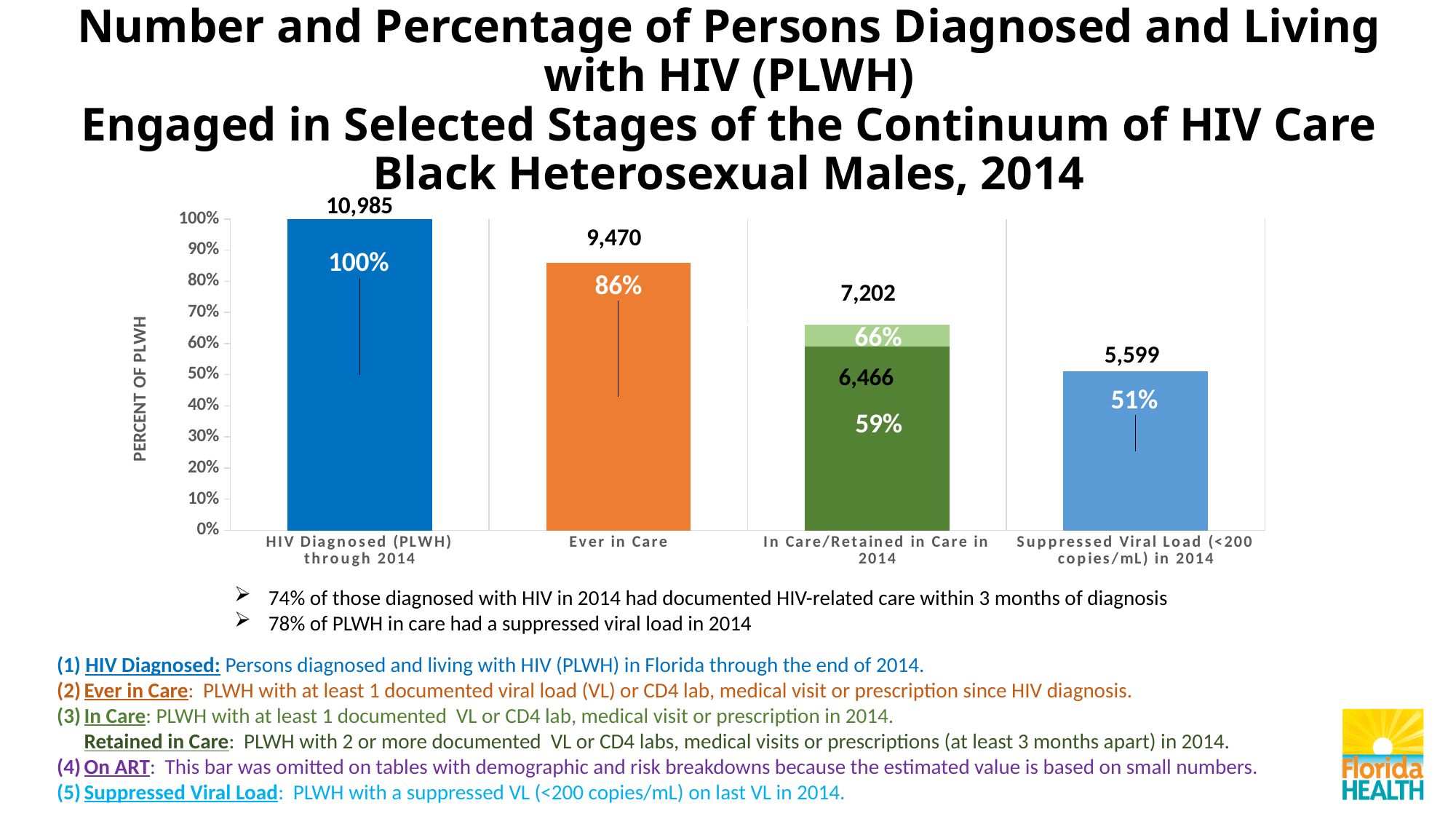
How many categories are shown on the x axis of the chart? 4 What percentage is shown on the 'Ever in Care' bar? 86% What is the number of persons shown above the 'In Care/Retained in Care in 2014' bar? 7,202 What is the difference in number of persons between 'HIV Diagnosed (PLWH) through 2014' and 'Ever in Care'? 1,515 What number is shown for the retained in care (dark green) portion of the 'In Care/Retained in Care in 2014' bar? 6,466 Which category has the highest number of persons? HIV Diagnosed (PLWH) through 2014 Which is larger, the number for 'Ever in Care' or the number for 'Suppressed Viral Load (<200 copies/mL) in 2014'? Ever in Care What percentage is shown for 'Suppressed Viral Load (<200 copies/mL) in 2014'? 51% What kind of chart is shown on the slide? bar chart Which category has the lowest number of persons? Suppressed Viral Load (<200 copies/mL) in 2014 What is the number of persons shown for the 'HIV Diagnosed (PLWH) through 2014' bar? 10,985 Do the bar values rise or fall moving from left to right along the x axis? fall